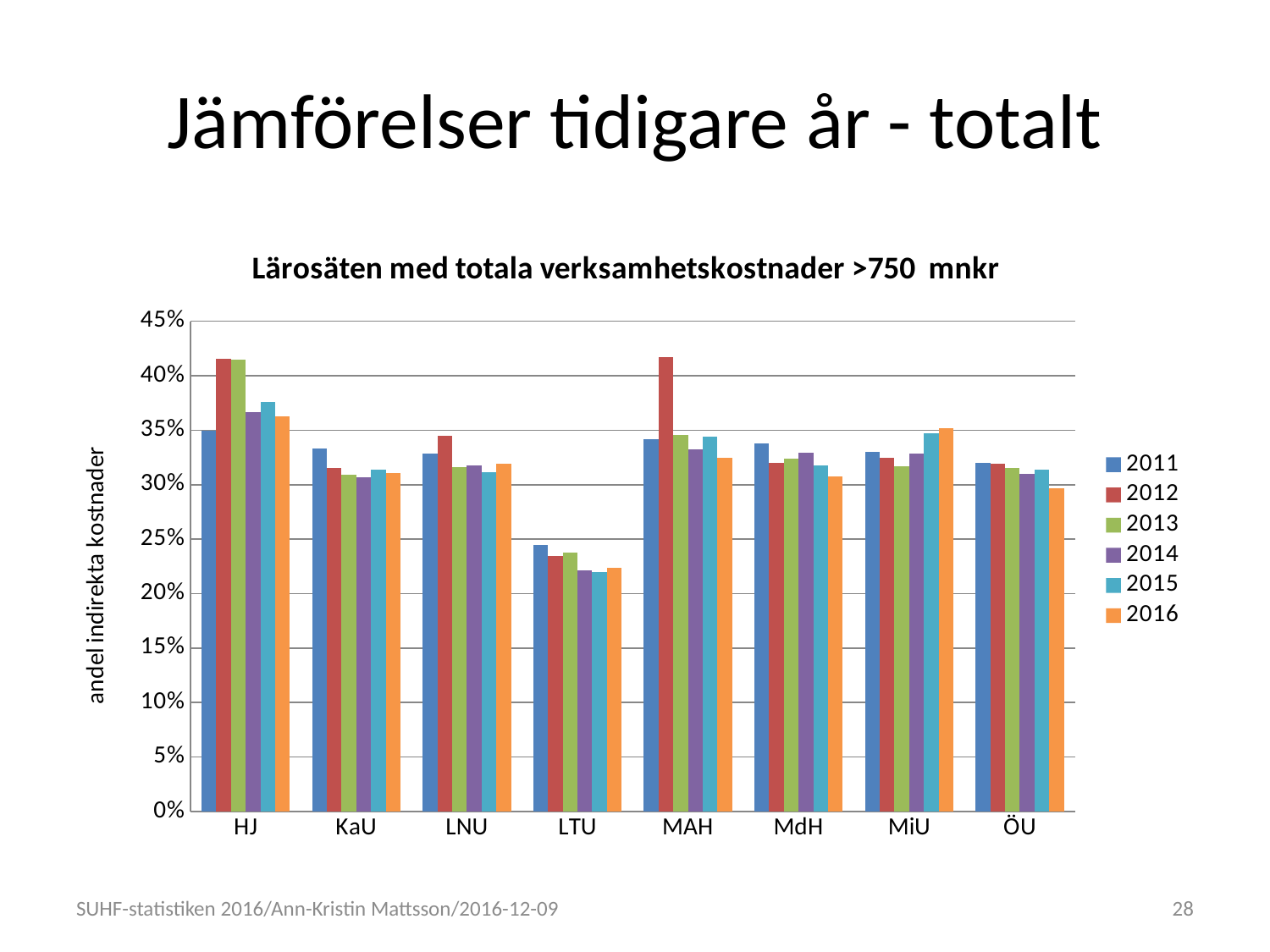
For LTU, which is larger: the value for 2011 or the value for 2014? 2011 How many series does the chart's legend list? 6 How many institutions (categories) are shown on the x axis of the chart? 8 Is the value for KaU in 2011 greater or less than 30%? greater Is the value for LTU in 2011 greater or less than 25%? less For MAH, which year has the highest value? 2012 Is the value for HJ in 2012 greater or less than 40%? greater What kind of chart is shown on the slide? bar chart For HJ, which is larger: the value for 2011 or the value for 2012? 2012 What is the title of the chart? Lärosäten med totala verksamhetskostnader >750 mnkr Which institution has the lowest values across all years in the chart? LTU